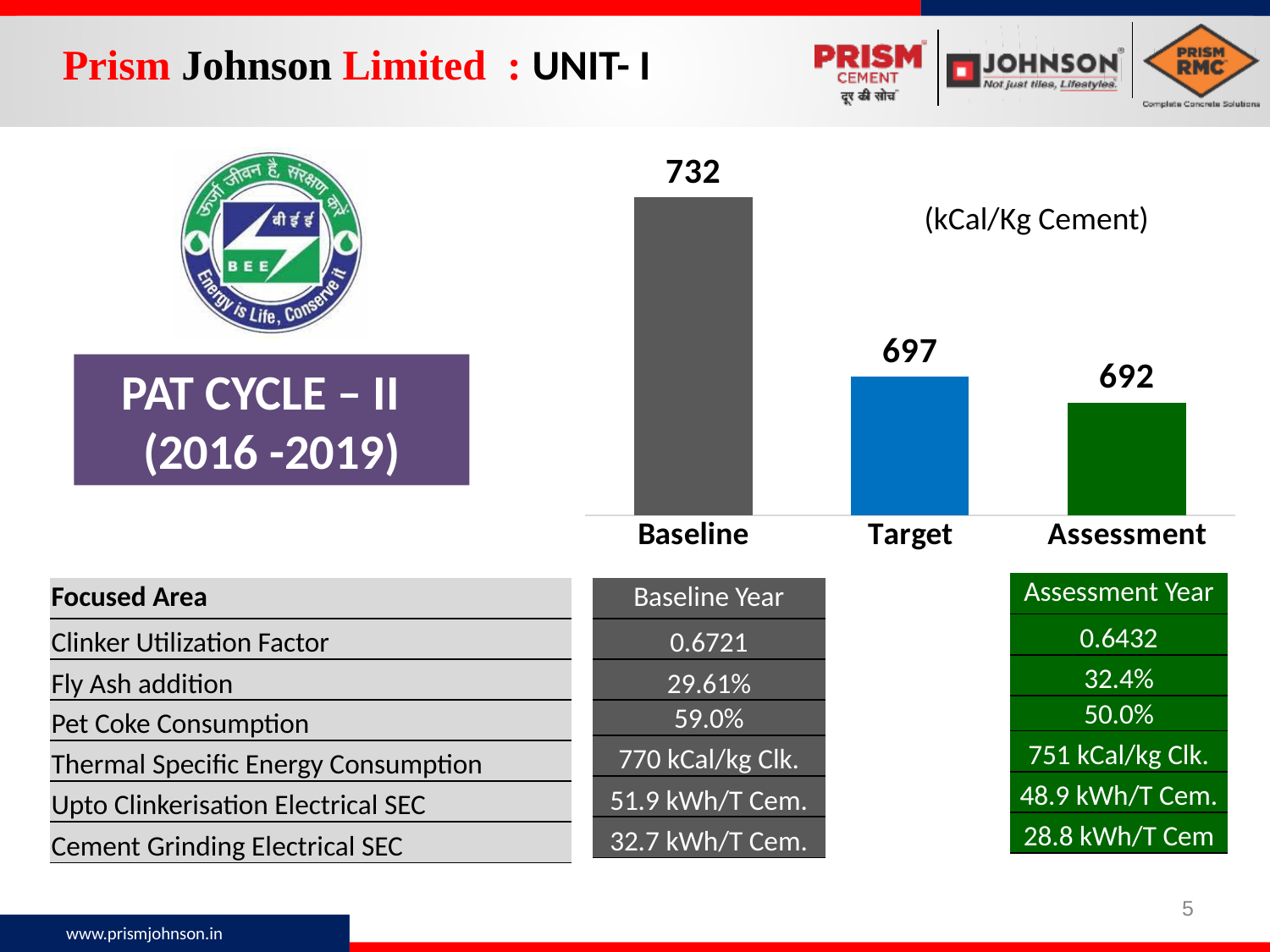
What is the difference between the Baseline and Assessment values? 40 Which category has the highest value in the bar chart? Baseline How many categories are shown in the bar chart? 3 Which is larger, the Target value or the Assessment value? Target What is the difference between the Baseline and Target values? 35 What kind of chart is shown on the slide? bar chart What is the value for Assessment in the bar chart? 692 What is the value for Target in the bar chart? 697 Which category has the lowest value in the bar chart? Assessment What is the value for Baseline in the bar chart? 732 What unit is shown next to the bar chart? kCal/Kg Cement Do the values rise or fall from Baseline to Assessment along the x axis? fall